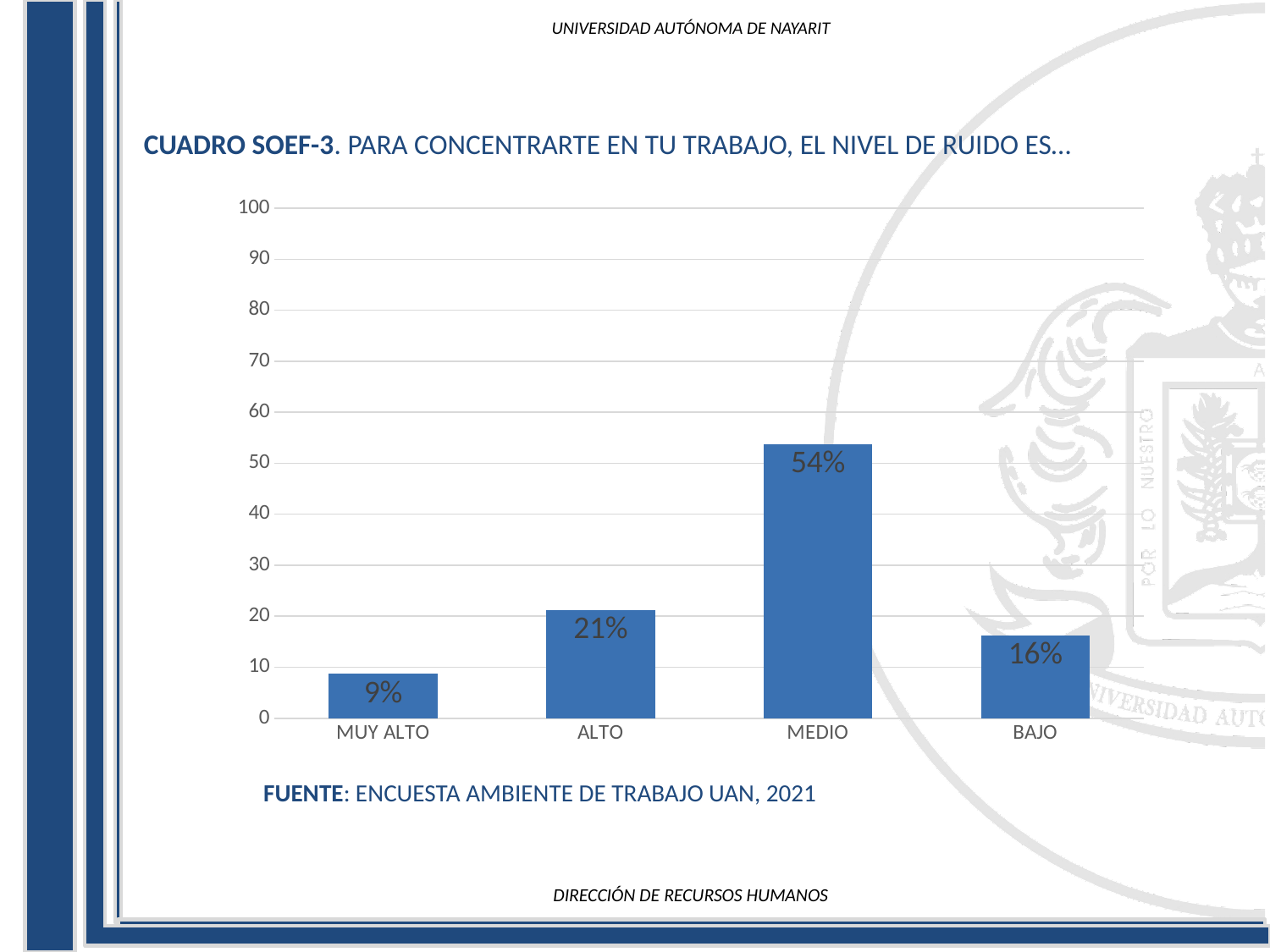
What is the value for MUY ALTO? 9% Which category has the lowest value? MUY ALTO What source is cited below the chart? ENCUESTA AMBIENTE DE TRABAJO UAN, 2021 What is the value for BAJO? 16% Is the value for MEDIO greater or less than 50? greater What is the value for MEDIO? 54% Which category has the highest value? MEDIO What kind of chart is shown on the slide? bar chart What is the difference between the values for MEDIO and ALTO? 33% What is the value for ALTO? 21% How many categories are shown on the x axis? 4 Which is larger, the value for ALTO or the value for BAJO? ALTO